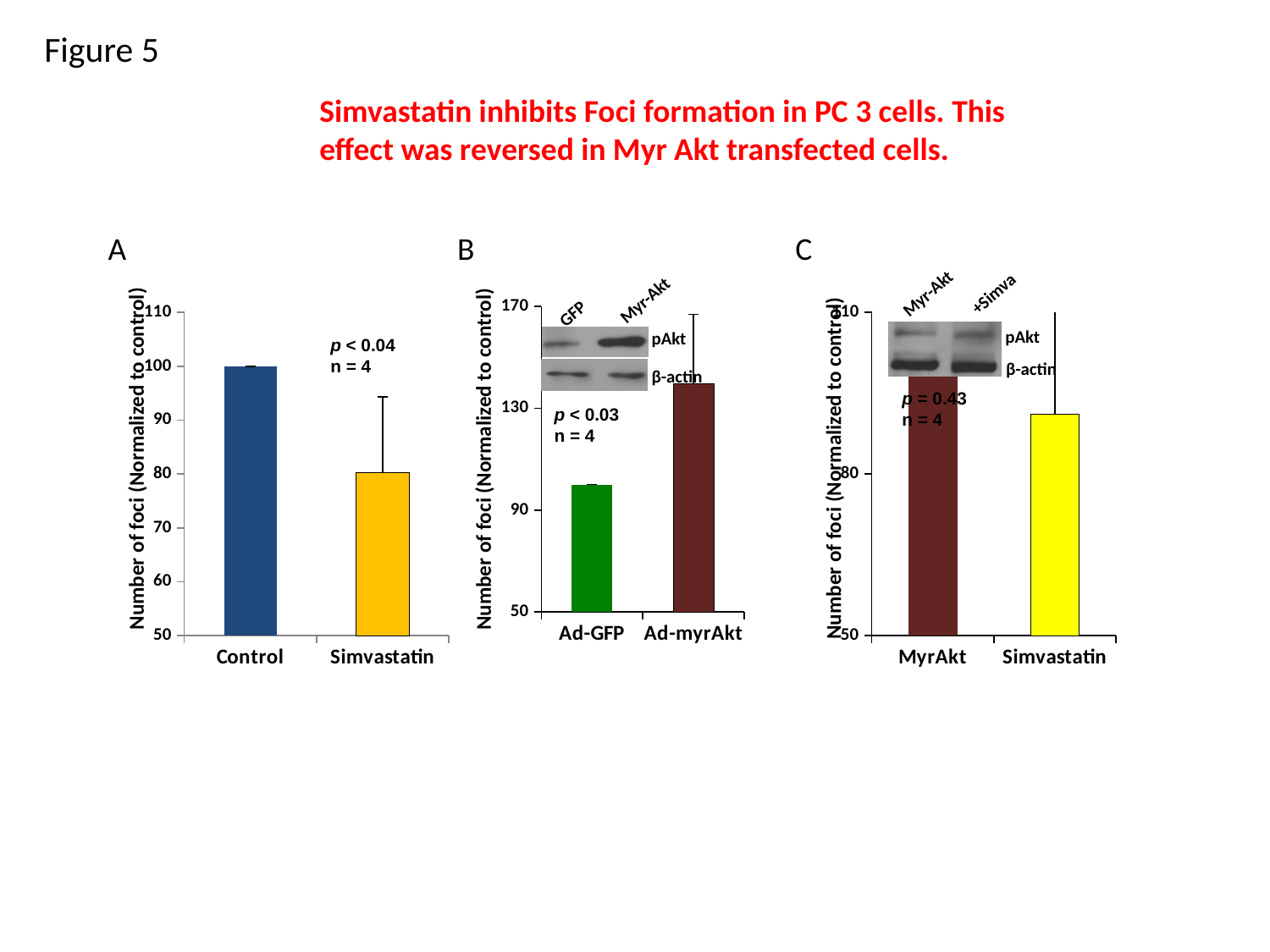
In chart A (the leftmost chart), which category has the higher value, Control or Simvastatin? Control In chart C (the rightmost chart), is the value for Simvastatin greater or less than 80? greater In chart A (the leftmost chart), what is the value for Control? 100 In chart B (the middle chart), which category has the higher value, Ad-GFP or Ad-myrAkt? Ad-myrAkt In chart B (the middle chart), is the value for Ad-GFP greater or less than 90? greater What is the y-axis label of chart B (the middle chart)? Number of foci (Normalized to control) What kind of chart is chart A (the leftmost chart)? bar chart In chart B (the middle chart), is the value for Ad-myrAkt greater or less than 130? greater How many categories are shown on the x axis of chart A (the leftmost chart)? 2 In chart C (the rightmost chart), what colour is the Simvastatin bar? yellow In chart C (the rightmost chart), which category has the higher value, MyrAkt or Simvastatin? MyrAkt